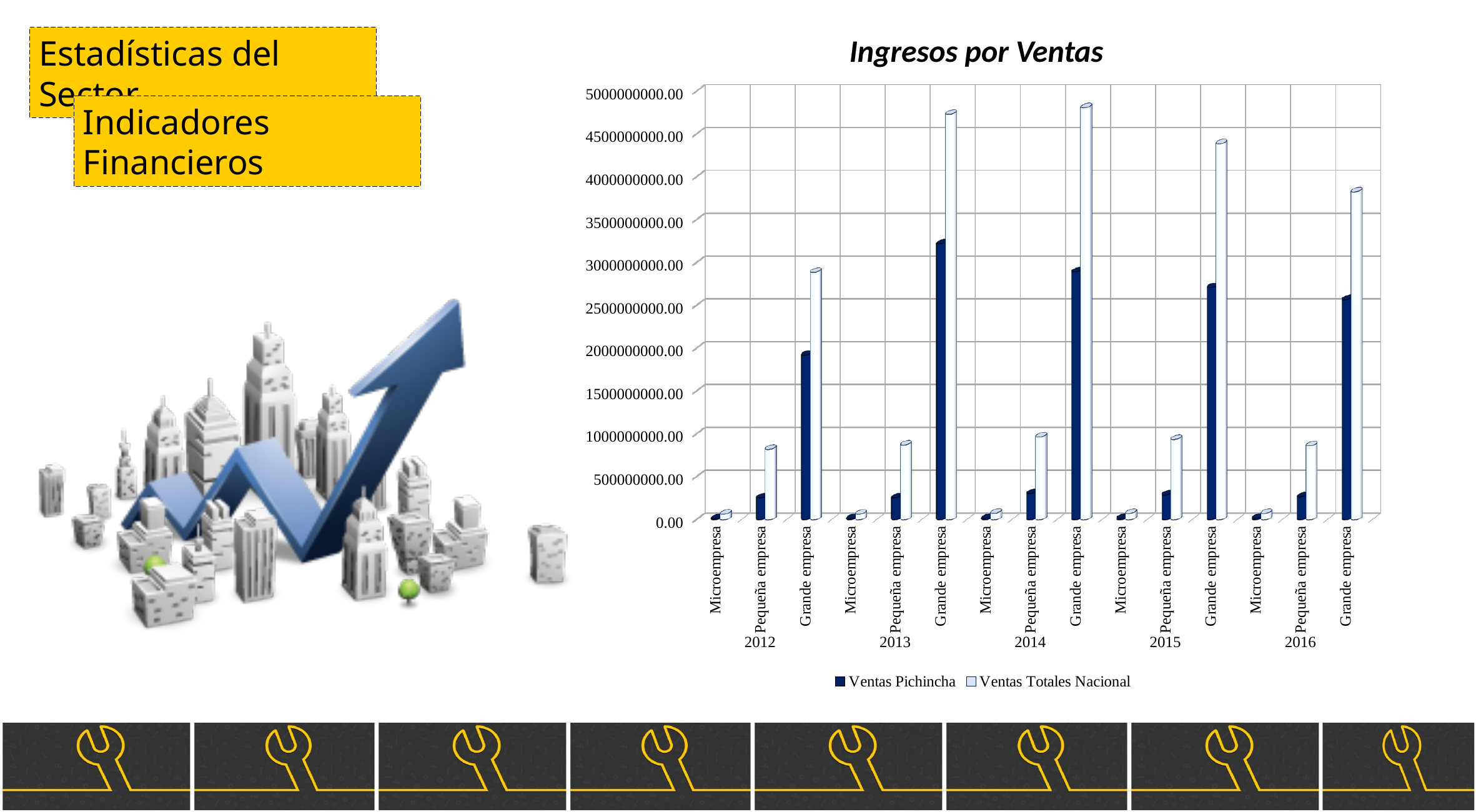
Is the Ventas Pichincha value for Grande empresa in 2013 greater or less than 3000000000.00? greater How many category bars groups (company size per year) are shown along the x axis? 15 Which two series are listed in the legend? Ventas Pichincha and Ventas Totales Nacional Which is larger for Ventas Totales Nacional: Grande empresa in 2012 or Grande empresa in 2016? Grande empresa in 2016 How many years are shown along the x axis? 5 What is the title of the chart? Ingresos por Ventas Is the Ventas Totales Nacional value for Grande empresa in 2016 greater or less than 4000000000.00? less What kind of chart is shown on the slide? bar chart How many series does the legend list? 2 For which year and company size is the Ventas Pichincha value highest? Grande empresa, 2013 Is the Ventas Totales Nacional value for Grande empresa in 2013 greater or less than 4500000000.00? greater